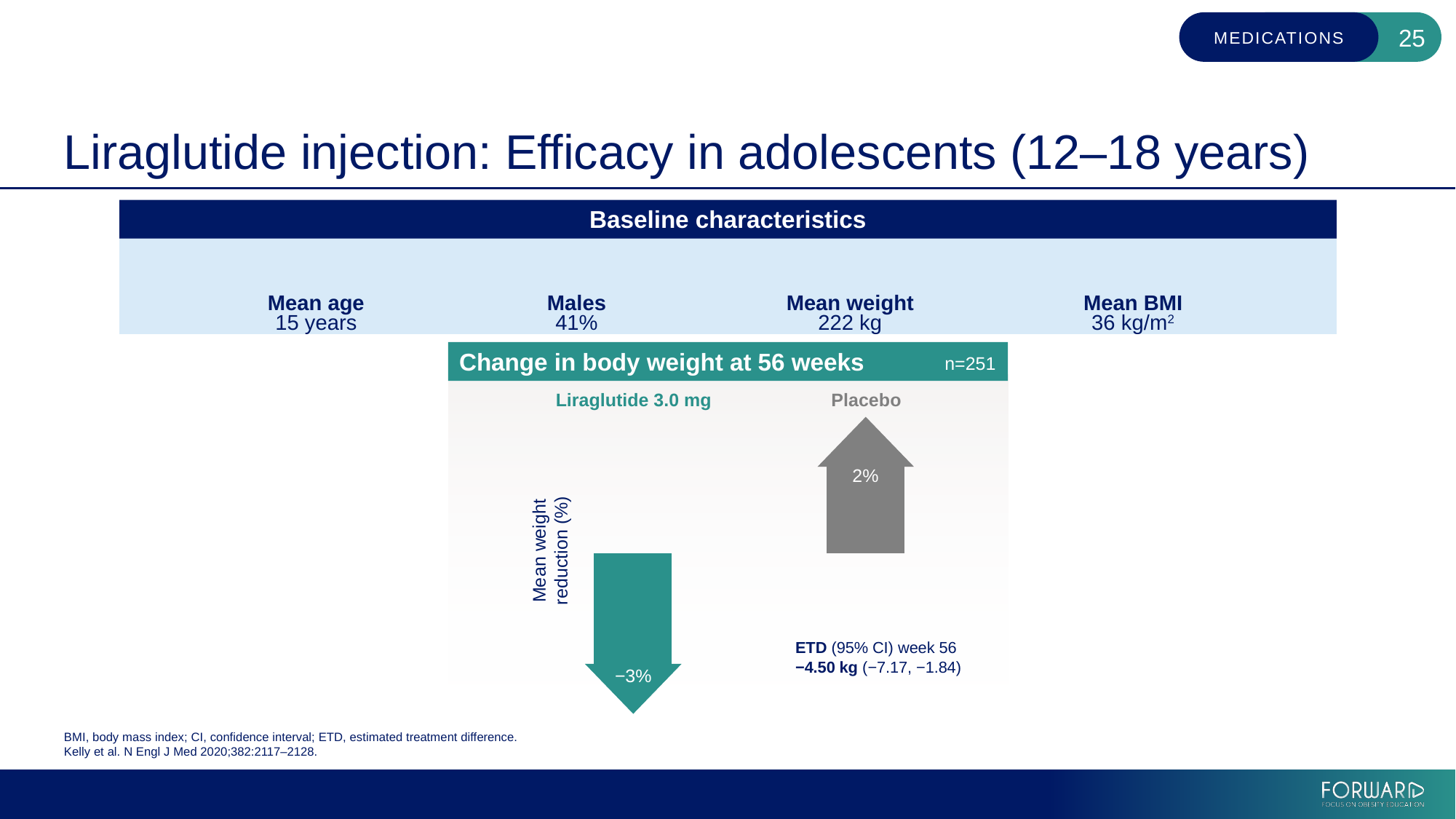
Which group shows an increase in body weight at 56 weeks? Placebo What is the label of the vertical axis of the chart? Mean weight reduction (%) What is the difference in percentage points between the Placebo change (2%) and the Liraglutide 3.0 mg change (−3%)? 5 percentage points What is the change in body weight at 56 weeks for Liraglutide 3.0 mg? −3% What is the sample size (n) shown for the change in body weight chart? n=251 What is the title of the chart? Change in body weight at 56 weeks Which group shows a reduction in body weight at 56 weeks? Liraglutide 3.0 mg What is the estimated treatment difference (ETD) at week 56 shown on the chart? −4.50 kg How many treatment groups are shown in the change in body weight chart? 2 Is the body weight change for Liraglutide 3.0 mg lower or higher than that for Placebo? lower What is the change in body weight at 56 weeks for Placebo? 2% What is the 95% confidence interval for the ETD at week 56? (−7.17, −1.84)